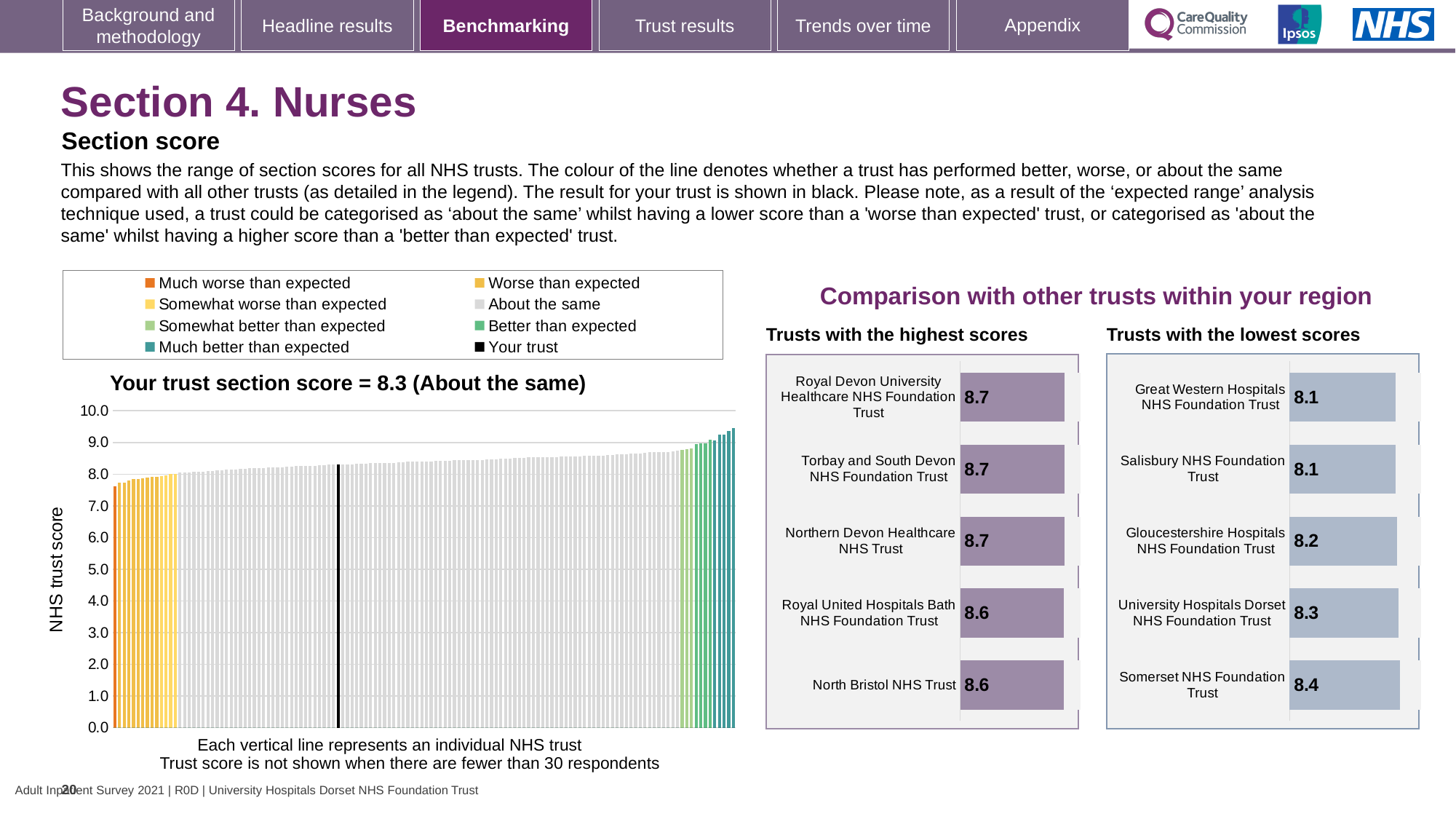
In the 'Trusts with the highest scores' chart, how many trusts are shown? 5 In the 'Your trust section score' chart, is the value of the highest bar greater or less than 9.0? greater In the 'Your trust section score' chart, is the value of the lowest bar greater or less than 8.0? less In the 'Your trust section score' chart, do the trust scores rise or fall from left to right along the x axis? rise In the 'Trusts with the lowest scores' chart, what is the difference between the scores of Somerset NHS Foundation Trust and Great Western Hospitals NHS Foundation Trust? 0.3 In the 'Your trust section score' chart, what is the section score for your trust? 8.3 What kind of chart is the 'Your trust section score' chart? bar chart In the 'Trusts with the lowest scores' chart, which trust has the highest score? Somerset NHS Foundation Trust In the 'Trusts with the highest scores' chart, what is the score for North Bristol NHS Trust? 8.6 In the 'Trusts with the lowest scores' chart, which has the larger score: Gloucestershire Hospitals NHS Foundation Trust or University Hospitals Dorset NHS Foundation Trust? University Hospitals Dorset NHS Foundation Trust How many entries does the legend above the 'Your trust section score' chart list? 8 In the 'Your trust section score' chart, which category is your trust placed in? About the same